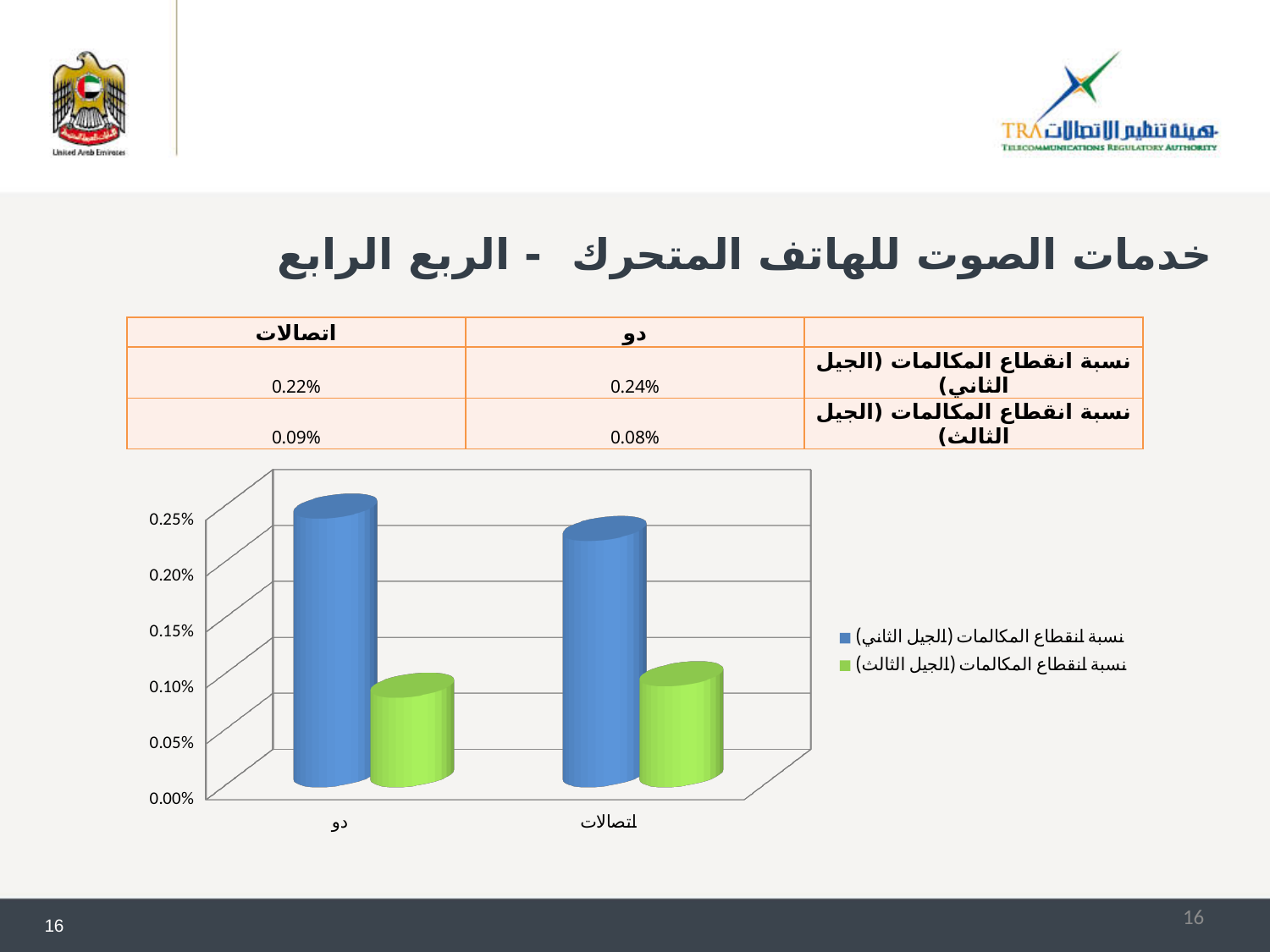
What type of chart is shown on the slide? bar chart How many series does the chart legend list? 2 Which operator has the higher value for نسبة انقطاع المكالمات (الجيل الثاني), دو or اتصالات? دو What is the difference between the نسبة انقطاع المكالمات (الجيل الثاني) and نسبة انقطاع المكالمات (الجيل الثالث) values for دو? 0.16% Is the value of نسبة انقطاع المكالمات (الجيل الثاني) for دو greater or less than 0.20%? greater How many categories are shown on the x axis of the chart? 2 What is the value of نسبة انقطاع المكالمات (الجيل الثاني) for دو? 0.24% What is the value of نسبة انقطاع المكالمات (الجيل الثالث) for اتصالات? 0.09% Is the value of نسبة انقطاع المكالمات (الجيل الثالث) for دو greater or less than 0.10%? less What is the difference between the نسبة انقطاع المكالمات (الجيل الثاني) values for دو and اتصالات? 0.02% What is the value of نسبة انقطاع المكالمات (الجيل الثاني) for اتصالات? 0.22% Which series is shown in green in the chart? نسبة انقطاع المكالمات (الجيل الثالث)